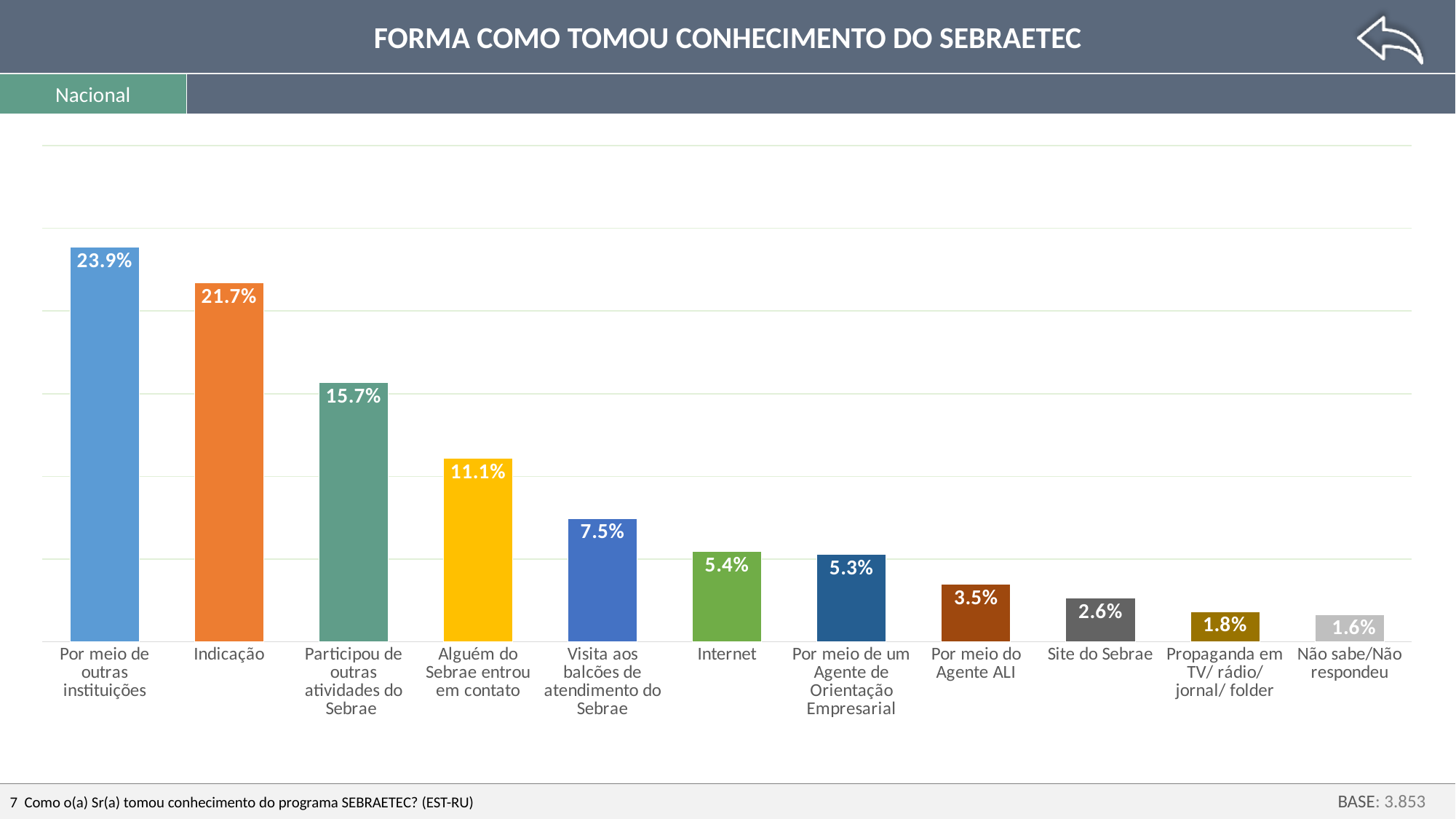
What is the value for "Site do Sebrae"? 2.6% How many categories are shown in the chart? 11 What kind of chart is shown on the slide? Bar chart What is the difference between the values for "Participou de outras atividades do Sebrae" and "Alguém do Sebrae entrou em contato"? 4.6% What is the value for "Por meio do Agente ALI"? 3.5% What is the difference between the values for "Por meio de outras instituições" and "Indicação"? 2.2% Do the values rise or fall from left to right along the x axis? Fall Which category has the highest value? Por meio de outras instituições What is the value for "Internet"? 5.4% Which is larger, the value for "Visita aos balcões de atendimento do Sebrae" or the value for "Internet"? Visita aos balcões de atendimento do Sebrae What is the value for "Indicação"? 21.7% Which category has the lowest value? Não sabe/Não respondeu